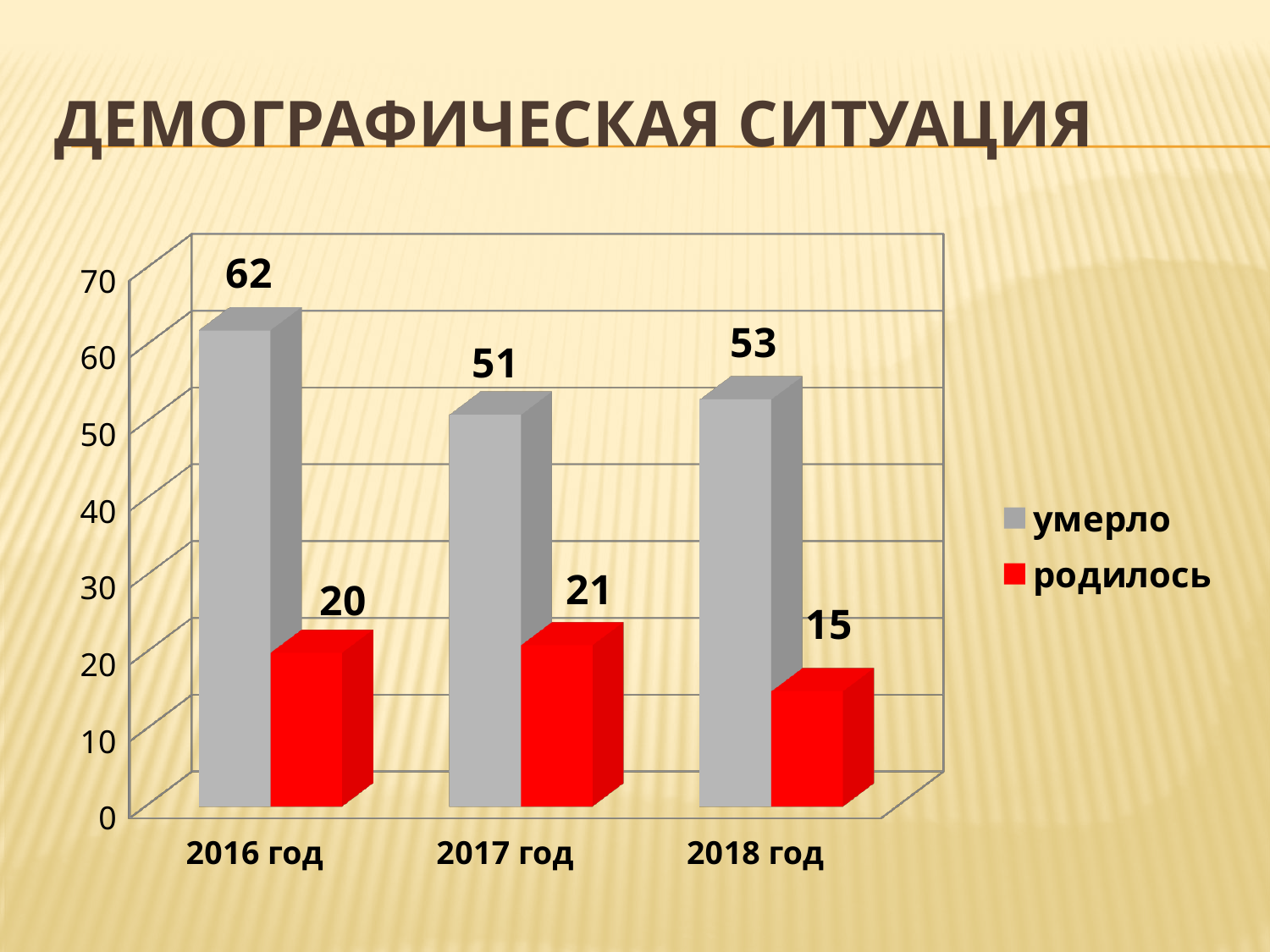
How many series does the legend list? 2 What kind of chart is shown on the slide? bar chart What is the value for родилось in 2017 год? 21 In which year is the value for родилось lowest? 2018 год How many years are shown on the x axis? 3 In which year is the value for умерло highest? 2016 год What is the difference between умерло in 2018 год and умерло in 2017 год? 2 What is the value for родилось in 2018 год? 15 Is the value for умерло in 2017 год greater or less than 50? greater What is the difference between умерло and родилось in 2016 год? 42 Which is larger: умерло in 2017 год or умерло in 2018 год? умерло in 2018 год What is the value for умерло in 2016 год? 62